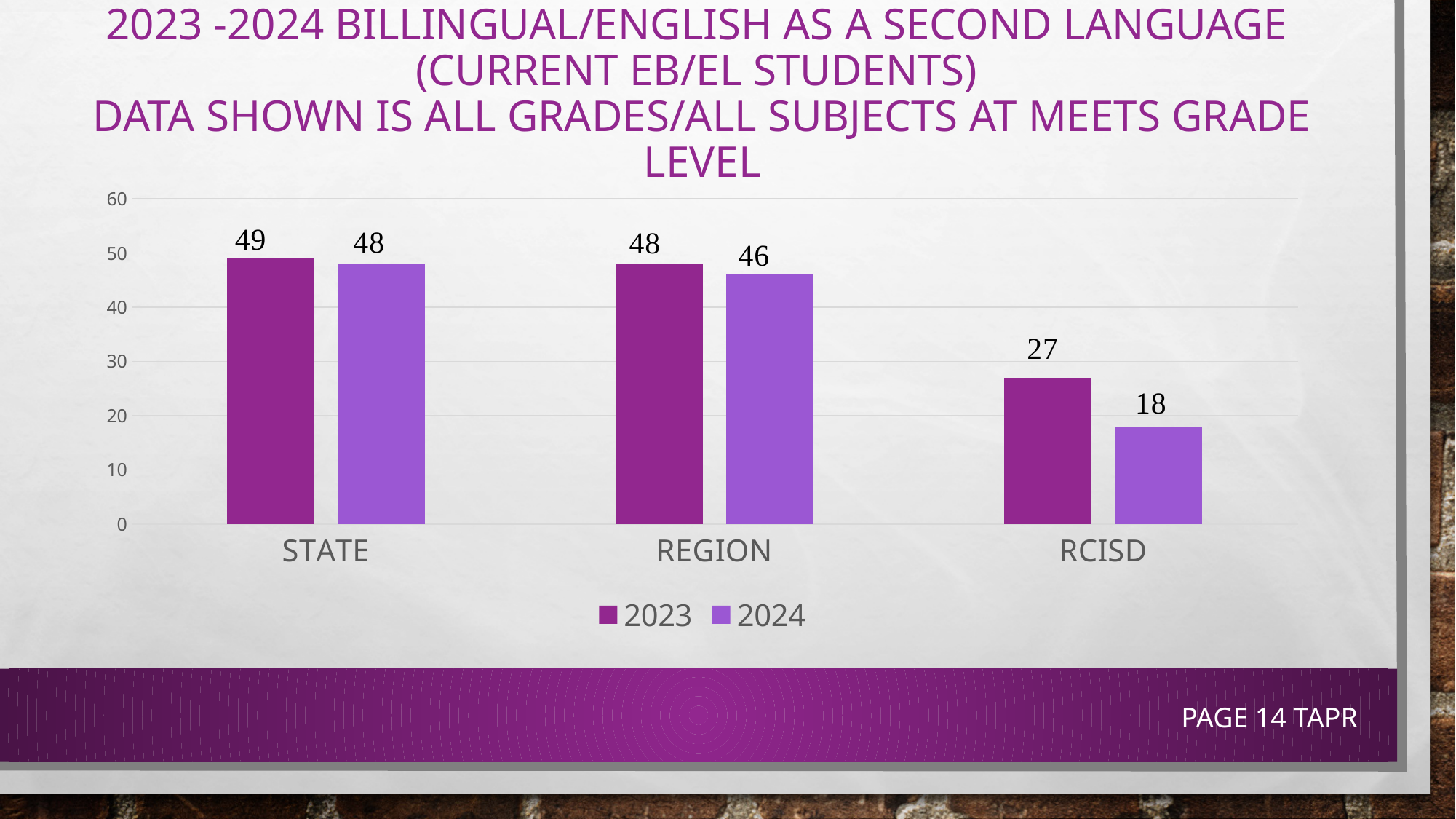
Which is larger, the 2024 value for STATE or the 2024 value for REGION? STATE Is the 2023 value for RCISD greater or less than 30? less What is the 2023 value for STATE? 49 Which category has the highest 2023 value? STATE Which category has the lowest 2024 value? RCISD What is the difference between the 2023 values for STATE and RCISD? 22 What kind of chart is shown on the slide? bar chart What is the 2024 value for REGION? 46 What is the 2024 value for RCISD? 18 How many categories are shown on the x axis? 3 What is the difference between the 2023 and 2024 values for RCISD? 9 How many series does the legend list? 2